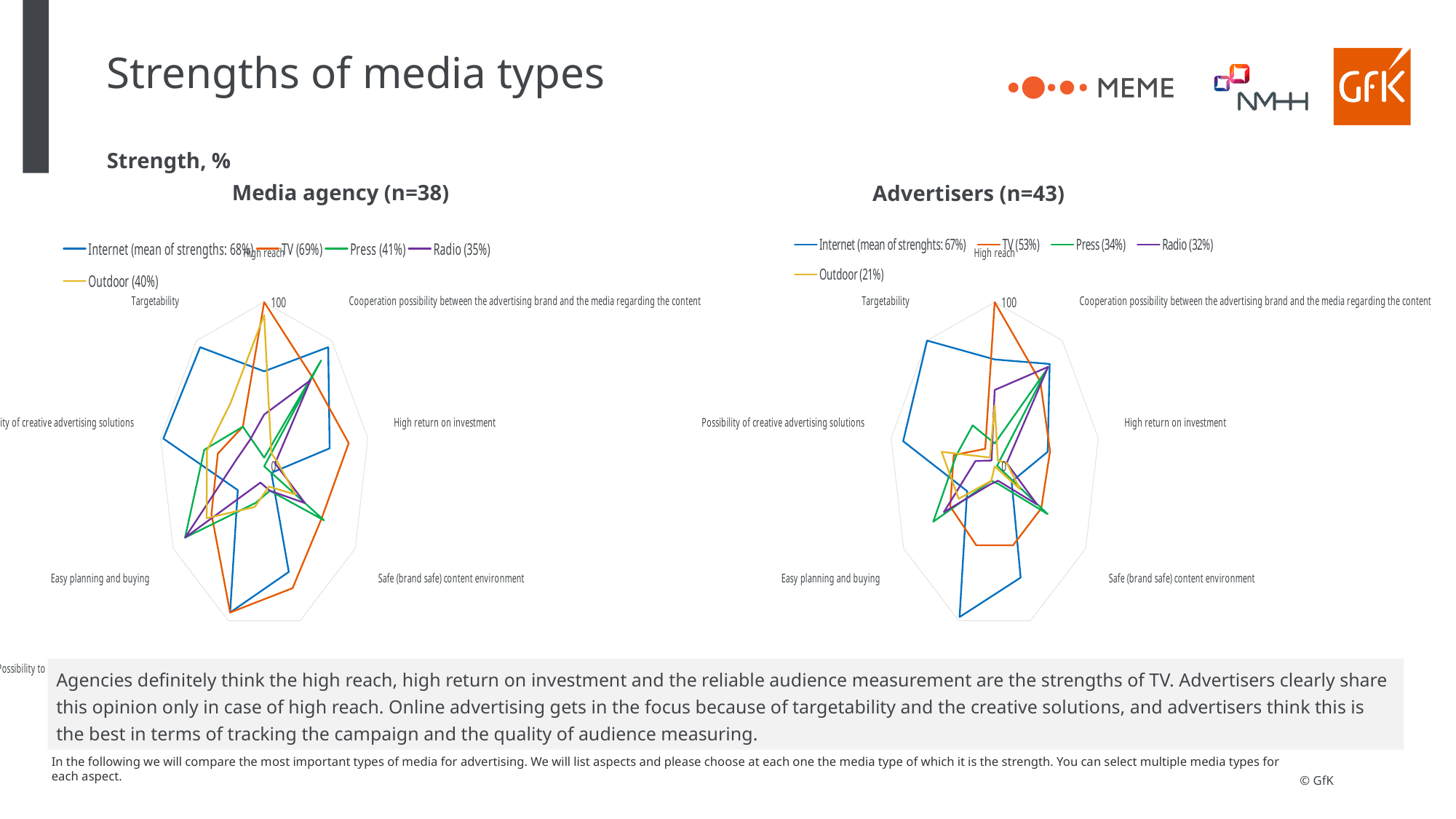
In the Advertisers (n=43) chart, which media type has the highest mean of strengths in the legend? Internet (67%) In the Media agency (n=38) chart, which media type has the lowest mean of strengths in the legend? Radio (35%) What kind of chart is used on this slide for the Media agency (n=38) and Advertisers (n=43) panels? Radar chart In the Media agency (n=38) chart, which has the higher legend mean of strengths, Press or Outdoor? Press (41%) In the Advertisers (n=43) chart, what is the mean of strengths shown in the legend for Outdoor? 21% In the Advertisers (n=43) chart, what is the mean of strengths shown in the legend for Internet? 67% In the Advertisers (n=43) chart, is the value for Internet on Targetability greater or less than 50? greater In the Media agency (n=38) chart, is the value for TV on High reach greater or less than 50? greater In the Advertisers (n=43) chart, what is the difference between the legend mean of strengths for Internet and for TV? 14 percentage points In the Media agency (n=38) chart, what is the mean of strengths shown in the legend for TV? 69% In the Advertisers (n=43) chart, how many series does the legend list? 5 In the Media agency (n=38) chart, how many series does the legend list? 5